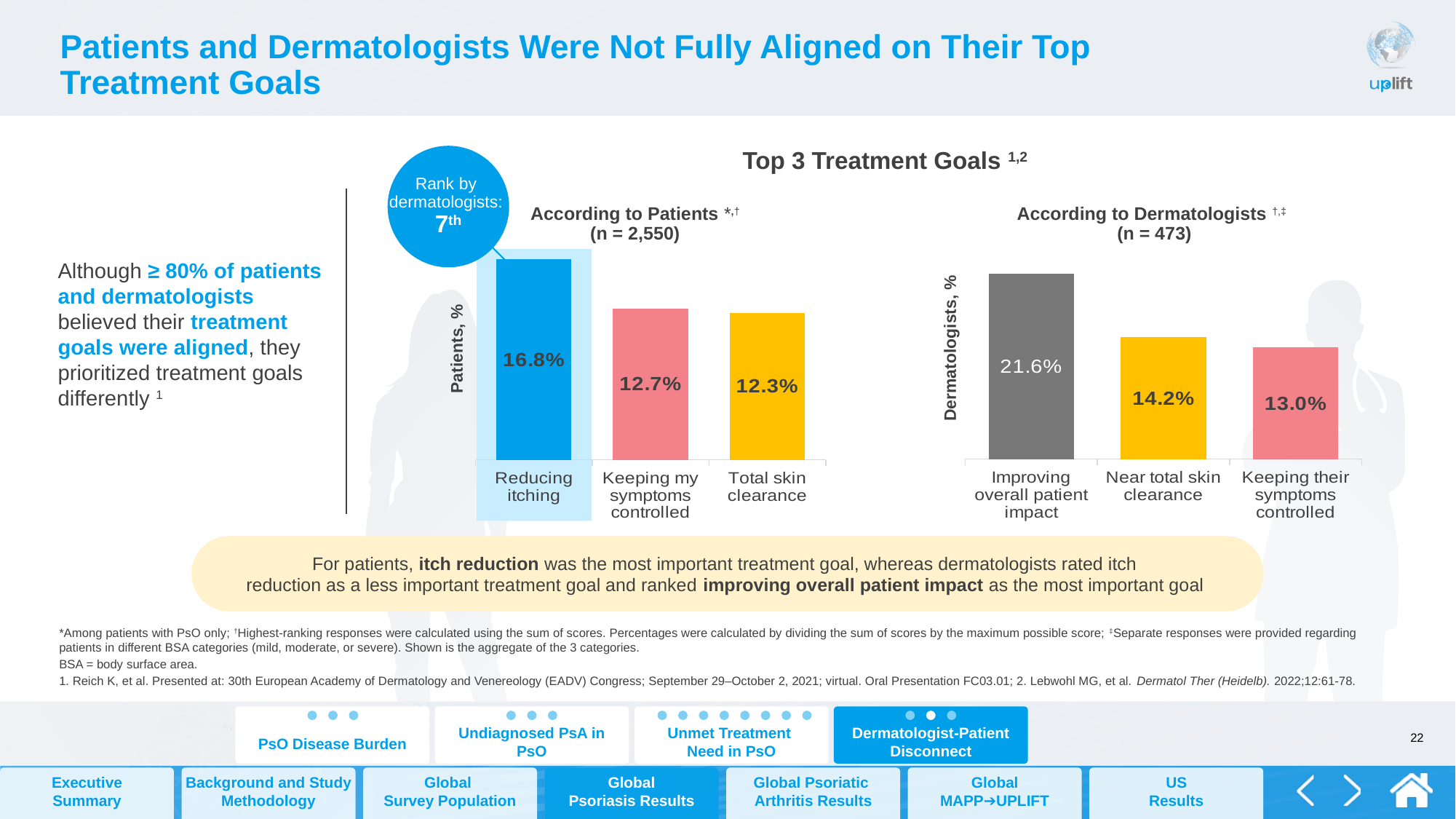
In the 'According to Dermatologists' chart, which category has the lowest value? Keeping their symptoms controlled Which is larger: Total skin clearance in the 'According to Patients' chart or Near total skin clearance in the 'According to Dermatologists' chart? Near total skin clearance (Dermatologists) In the 'According to Dermatologists' chart, what is the value for Improving overall patient impact? 21.6% In the 'According to Patients' chart, what is the value for Reducing itching? 16.8% How many categories are shown in the 'According to Dermatologists' chart? 3 What type of chart is the 'According to Patients' chart? Bar chart In the 'According to Patients' chart, which category has the highest value? Reducing itching In the 'According to Patients' chart, what is the difference between Reducing itching and Keeping my symptoms controlled? 4.1% In the 'According to Patients' chart, what is the value for Total skin clearance? 12.3% What is the sample size (n) shown for the 'According to Dermatologists' chart? n = 473 In the 'According to Dermatologists' chart, what is the value for Near total skin clearance? 14.2% In the 'According to Dermatologists' chart, what is the difference between Improving overall patient impact and Keeping their symptoms controlled? 8.6%